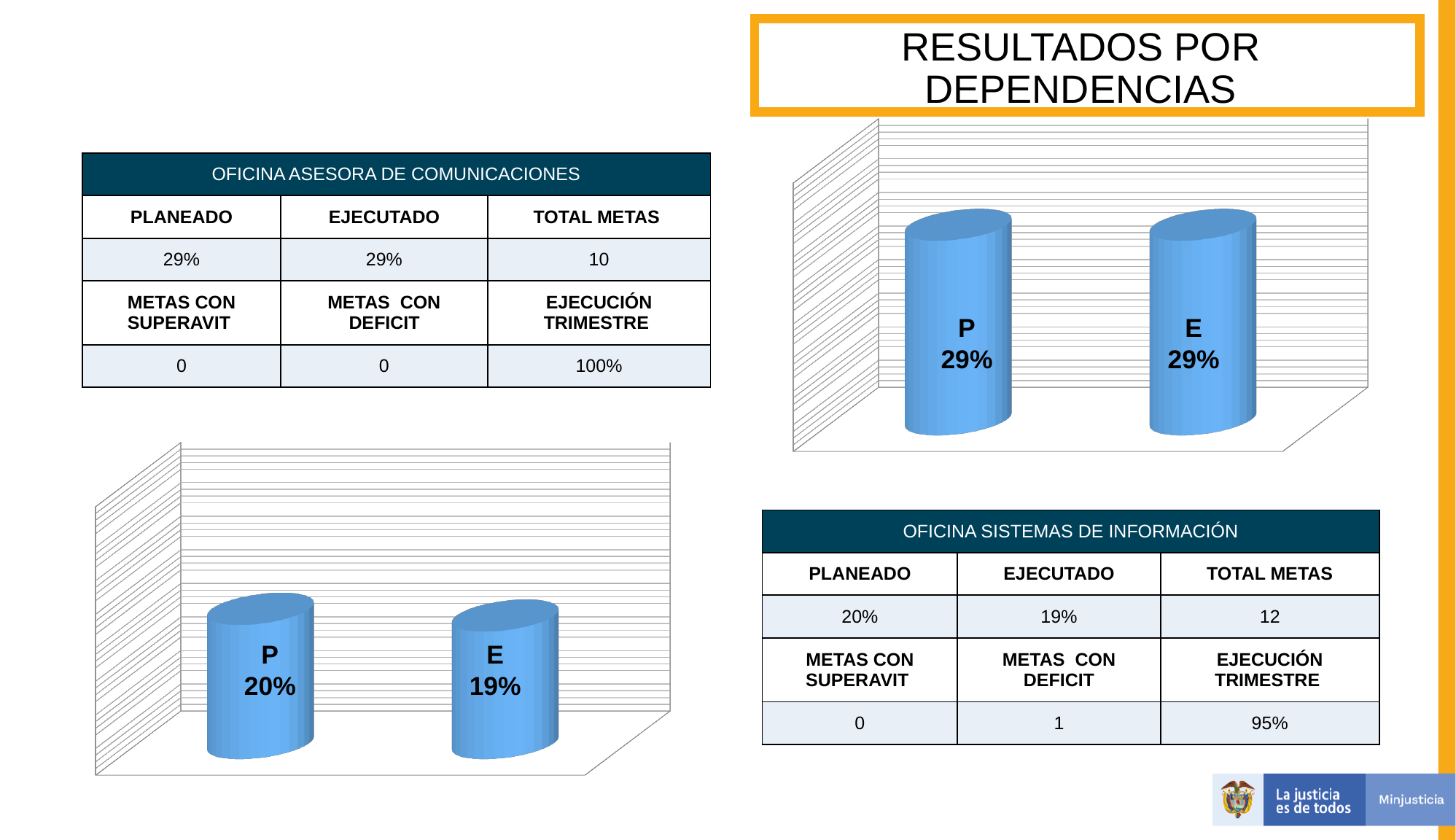
How many bars are plotted in the chart at the bottom left of the slide? 2 In the chart at the top right of the slide, what is the difference between the values for P and E? 0% In the chart at the bottom left of the slide, what is the value labelled for P? 20% What kind of chart is shown at the bottom left of the slide? Bar chart In the chart at the bottom left of the slide, what is the difference between the values for P and E? 1% In the chart at the bottom left of the slide, which bar has the higher value, P or E? P How many bars are plotted in the chart at the top right of the slide? 2 In the chart at the bottom left of the slide, which category has the lowest value? E In the chart at the bottom left of the slide, what is the value labelled for E? 19% In the chart at the top right of the slide, what is the value labelled for E? 29% In the chart at the top right of the slide, what is the value labelled for P? 29% What colour are the bars in the chart at the top right of the slide? Blue